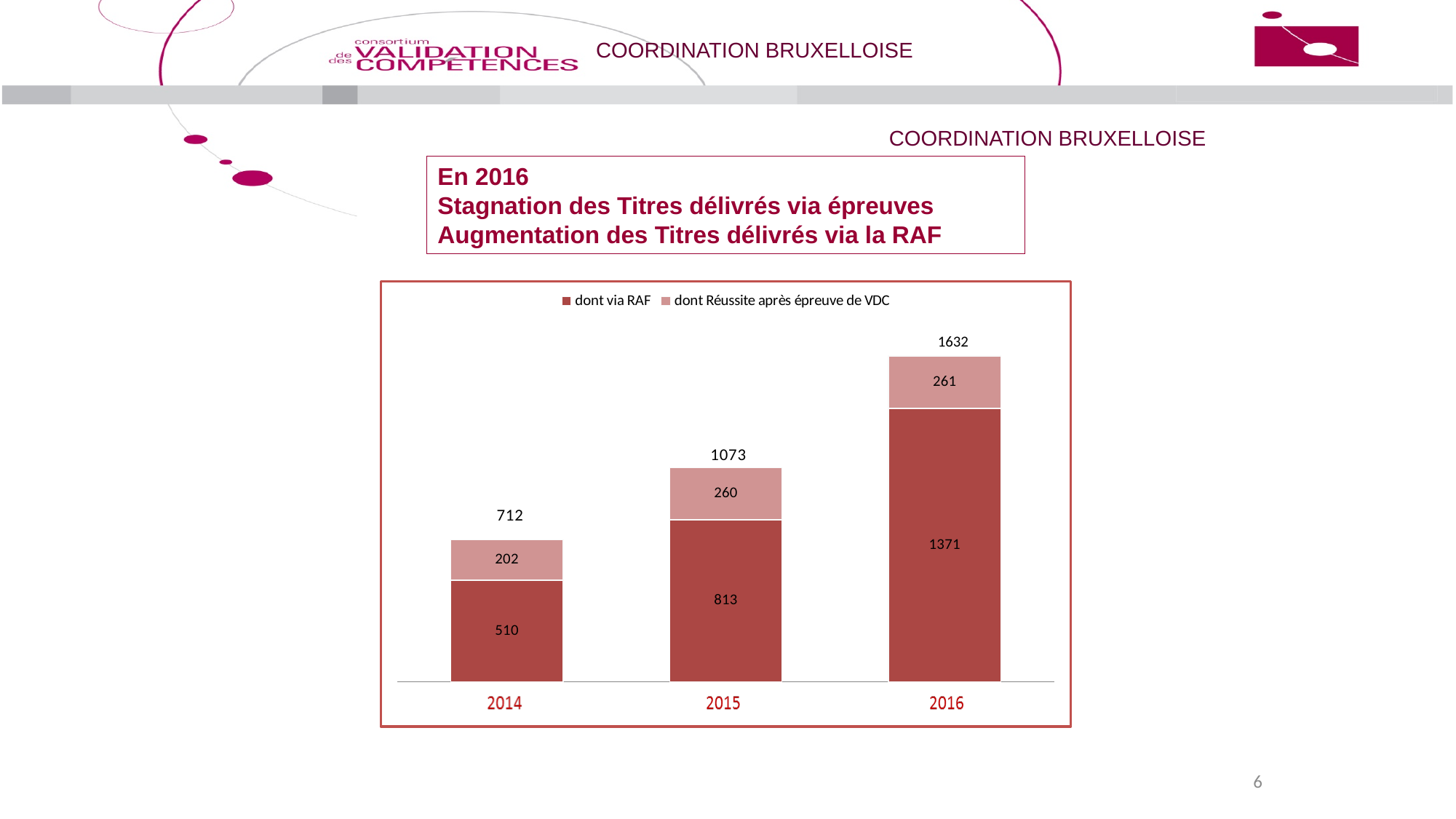
What is the difference between the 'dont via RAF' values for 2016 and 2015? 558 How many series does the legend list? 2 What kind of chart is shown? Stacked bar chart Do the total values rise or fall from 2014 to 2016? Rise What is the value for 'dont Réussite après épreuve de VDC' in 2014? 202 Which year has the lowest value for 'dont via RAF'? 2014 What is the total of the stacked bar for 2015? 1073 Which year has the highest total? 2016 How many years are shown on the x axis? 3 What is the value for 'dont via RAF' in 2015? 813 What is the value for 'dont via RAF' in 2016? 1371 Which is larger: 'dont Réussite après épreuve de VDC' in 2015 or in 2014? 2015